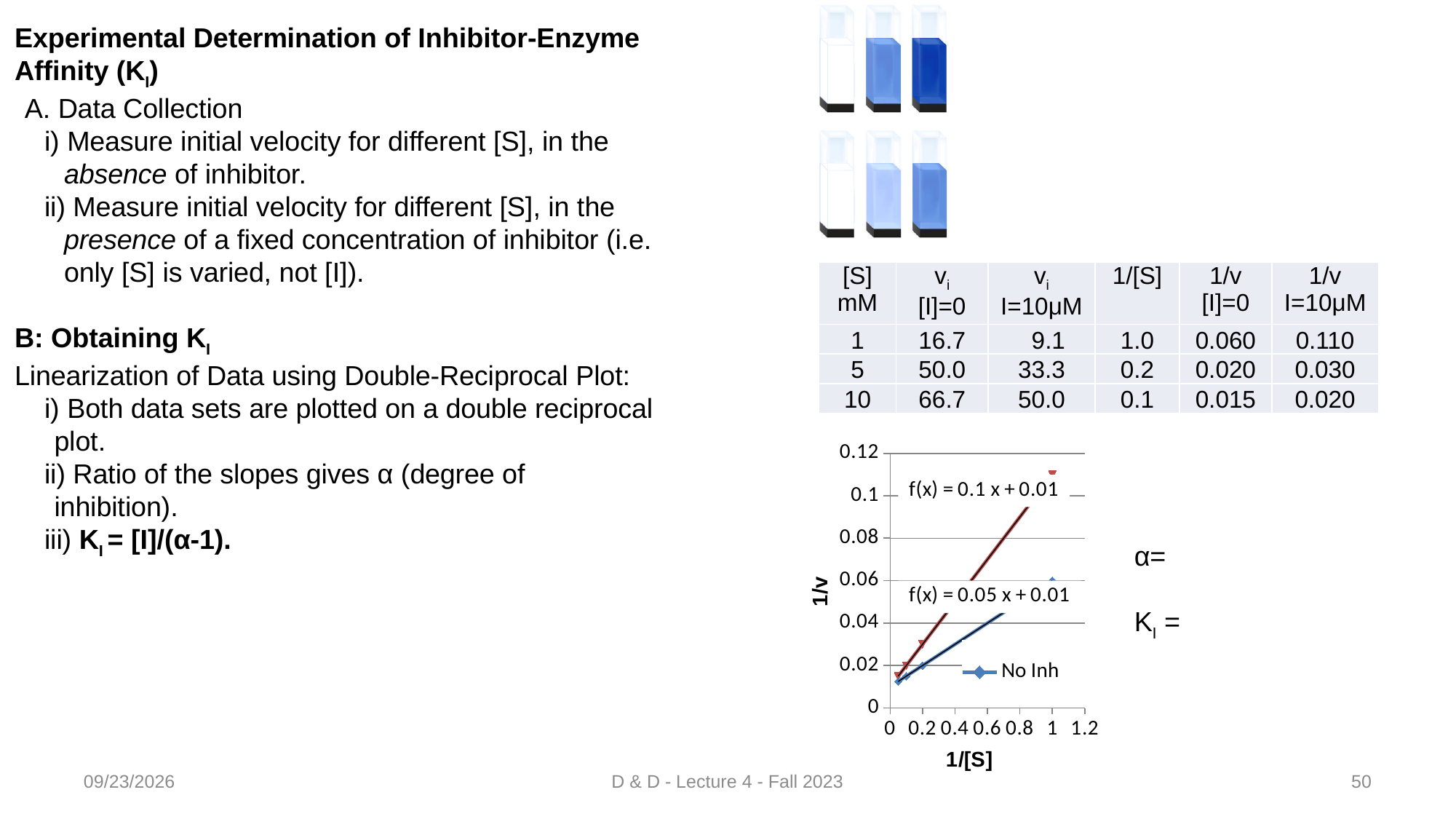
At 1/[S] = 1, is the 1/v value for the No Inh series greater or less than 0.04? greater At 1/[S] = 1, which series has the larger 1/v value, the red (inhibitor) series or the blue No Inh series? the red (inhibitor) series What is the trendline equation shown for the lower (blue) series in the chart? f(x) = 0.05 x + 0.01 How many data points are plotted for the No Inh series? 4 What is the trendline equation shown for the upper (red) series in the chart? f(x) = 0.1 x + 0.01 Which series has the steeper trendline slope, the red (inhibitor) series or the blue No Inh series? the red (inhibitor) series What is the label of the y axis of the chart? 1/v What type of chart is shown on the slide? scatter chart with trendlines According to the table, what is the 1/v value for [I]=0 at 1/[S] = 1.0? 0.060 Do the 1/v values rise or fall as 1/[S] increases along the x axis? rise At 1/[S] = 1, is the 1/v value for the red (inhibitor) series greater or less than 0.1? greater What is the label of the x axis of the chart? 1/[S]